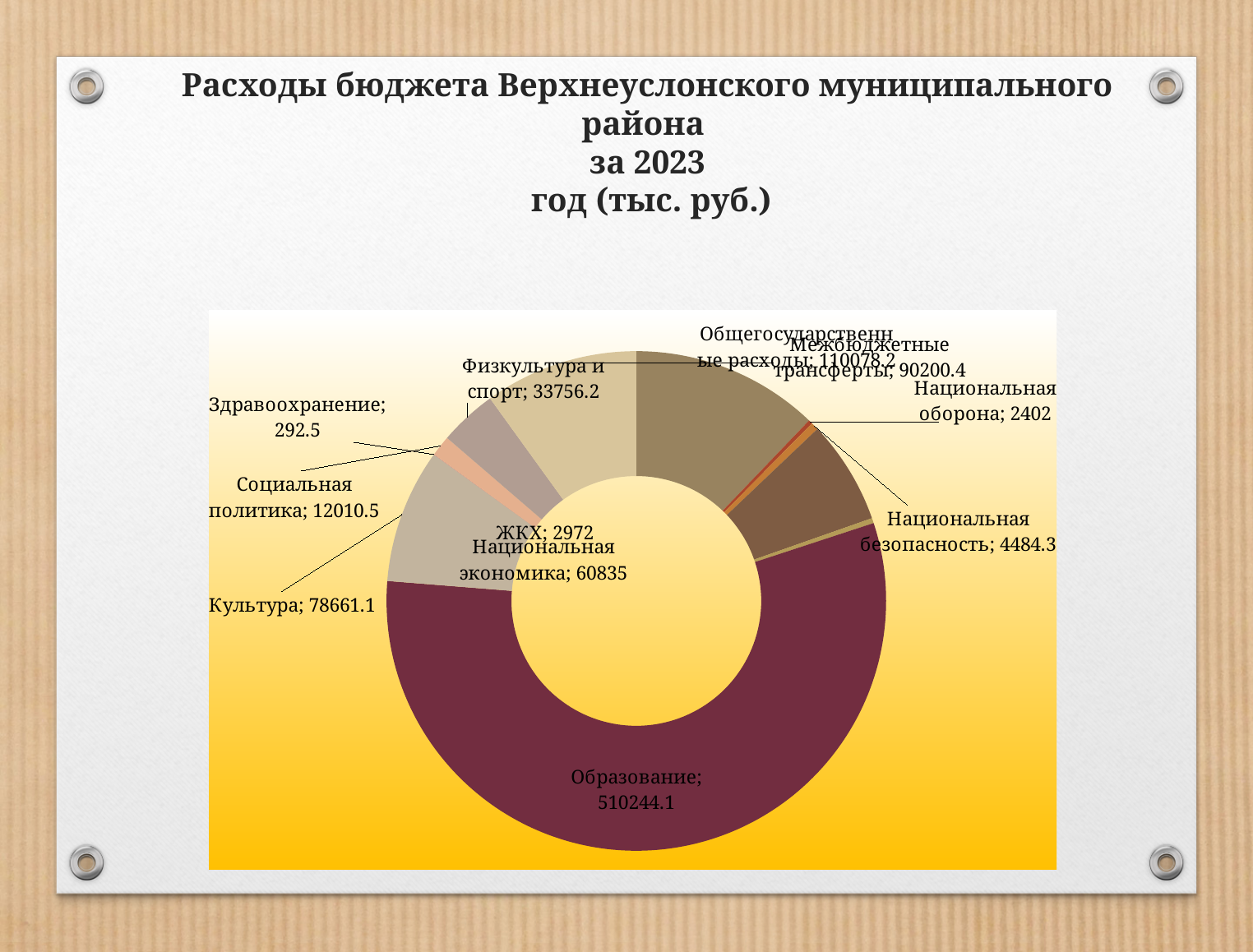
What is the value for Физкультура и спорт? 33756.2 How many categories are shown in the chart? 11 In what units are the values in the chart expressed, according to the title? тыс. руб. What is the value for Образование? 510244.1 Which is larger, Физкультура и спорт or Социальная политика? Физкультура и спорт What is the value for Культура? 78661.1 What is the difference between Общегосударственные расходы and Межбюджетные трансферты? 19877.8 Which category has the smallest value? Здравоохранение What kind of chart is shown on the slide? Doughnut (pie) chart Which category has the largest value? Образование What is the difference between Культура and Национальная экономика? 17826.1 What is the value for Национальная оборона? 2402